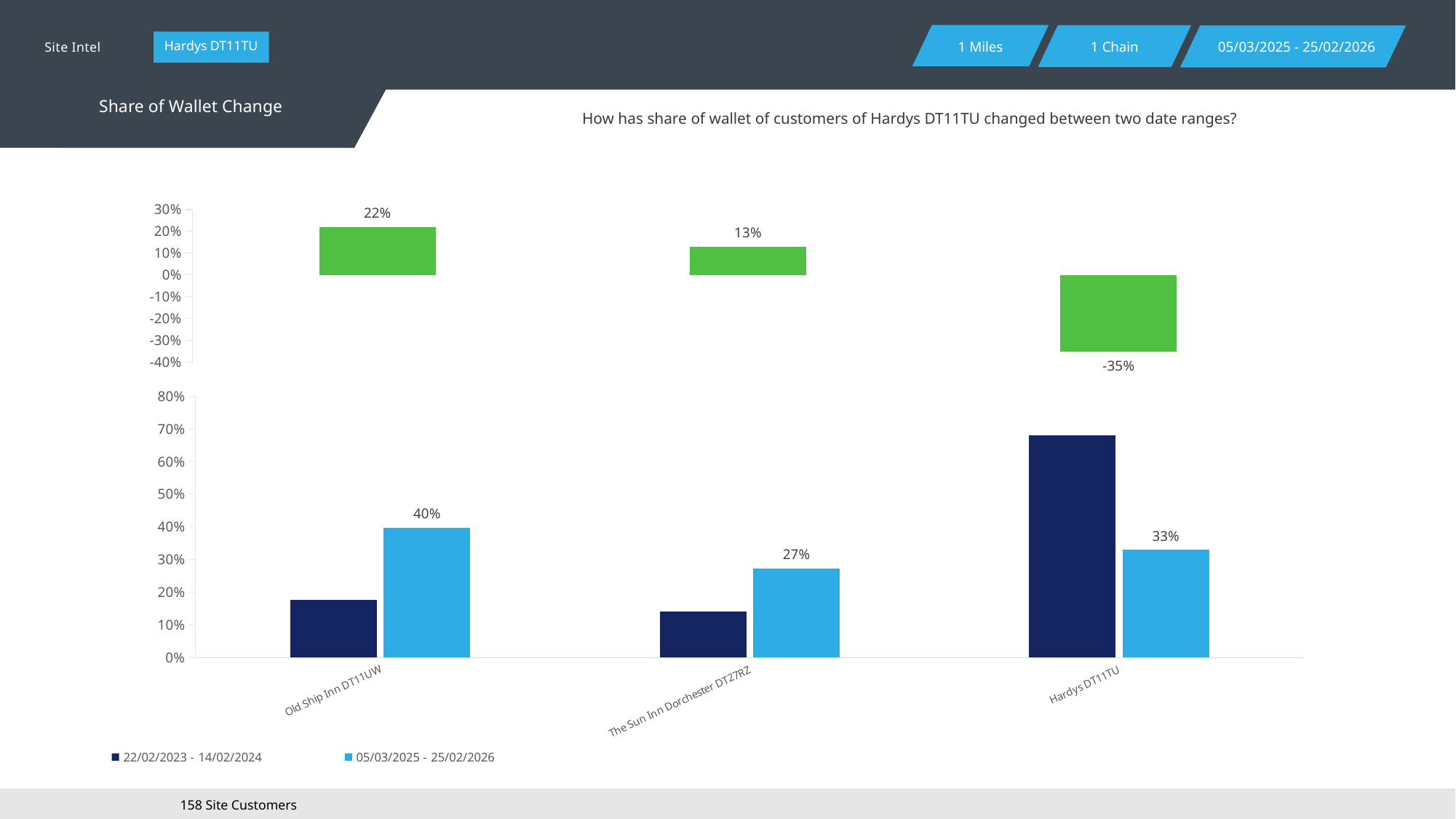
In the top chart, what is the difference between the change for Old Ship Inn DT11UW and The Sun Inn Dorchester DT27RZ? 9 percentage points In the top chart, which category has the lowest share of wallet change? Hardys DT11TU In the bottom chart, is the value for The Sun Inn Dorchester DT27RZ in 22/02/2023 - 14/02/2024 greater or less than 20%? less In the top chart, what is the share of wallet change for Hardys DT11TU? -35% In the bottom chart, which is larger for Hardys DT11TU: the 22/02/2023 - 14/02/2024 value or the 05/03/2025 - 25/02/2026 value? 22/02/2023 - 14/02/2024 What kind of chart is the bottom chart? Bar chart In the bottom chart, what is the share of wallet for The Sun Inn Dorchester DT27RZ in 05/03/2025 - 25/02/2026? 27% In the bottom chart, is the value for Hardys DT11TU in 22/02/2023 - 14/02/2024 greater or less than 60%? greater In the bottom chart, what is the share of wallet for Old Ship Inn DT11UW in 05/03/2025 - 25/02/2026? 40% In the top chart, what is the share of wallet change for Old Ship Inn DT11UW? 22% In the bottom chart, which category has the highest value in the 05/03/2025 - 25/02/2026 series? Old Ship Inn DT11UW How many series does the legend of the bottom chart list? 2